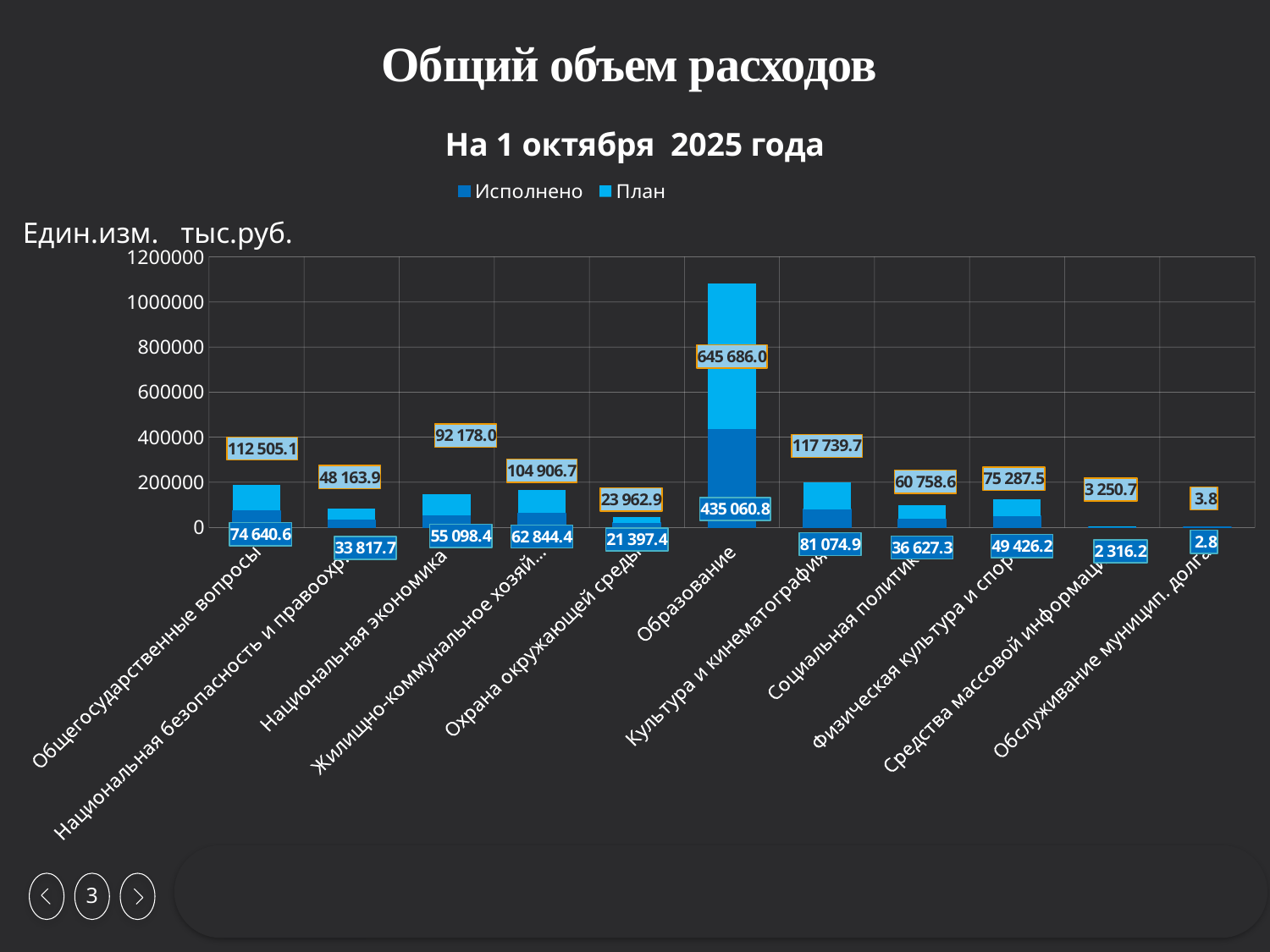
What is the total of the stacked bar for Охрана окружающей среды? 45 360.3 What is the difference between the План and Исполнено values for Образование? 210 625.2 Which category has the highest План value? Образование What unit of measurement is stated above the chart? тыс.руб. How many categories are shown on the x axis? 11 How many series does the legend list? 2 Which is larger: the Исполнено value for Национальная экономика or for Социальная политика? Национальная экономика What is the Исполнено value for Культура и кинематография? 81 074.9 What type of chart is shown on the slide? bar chart What is the План value for Образование? 645 686.0 What is the Исполнено value for Средства массовой информации? 2 316.2 Which category has the lowest Исполнено value? Обслуживание муницип. долга